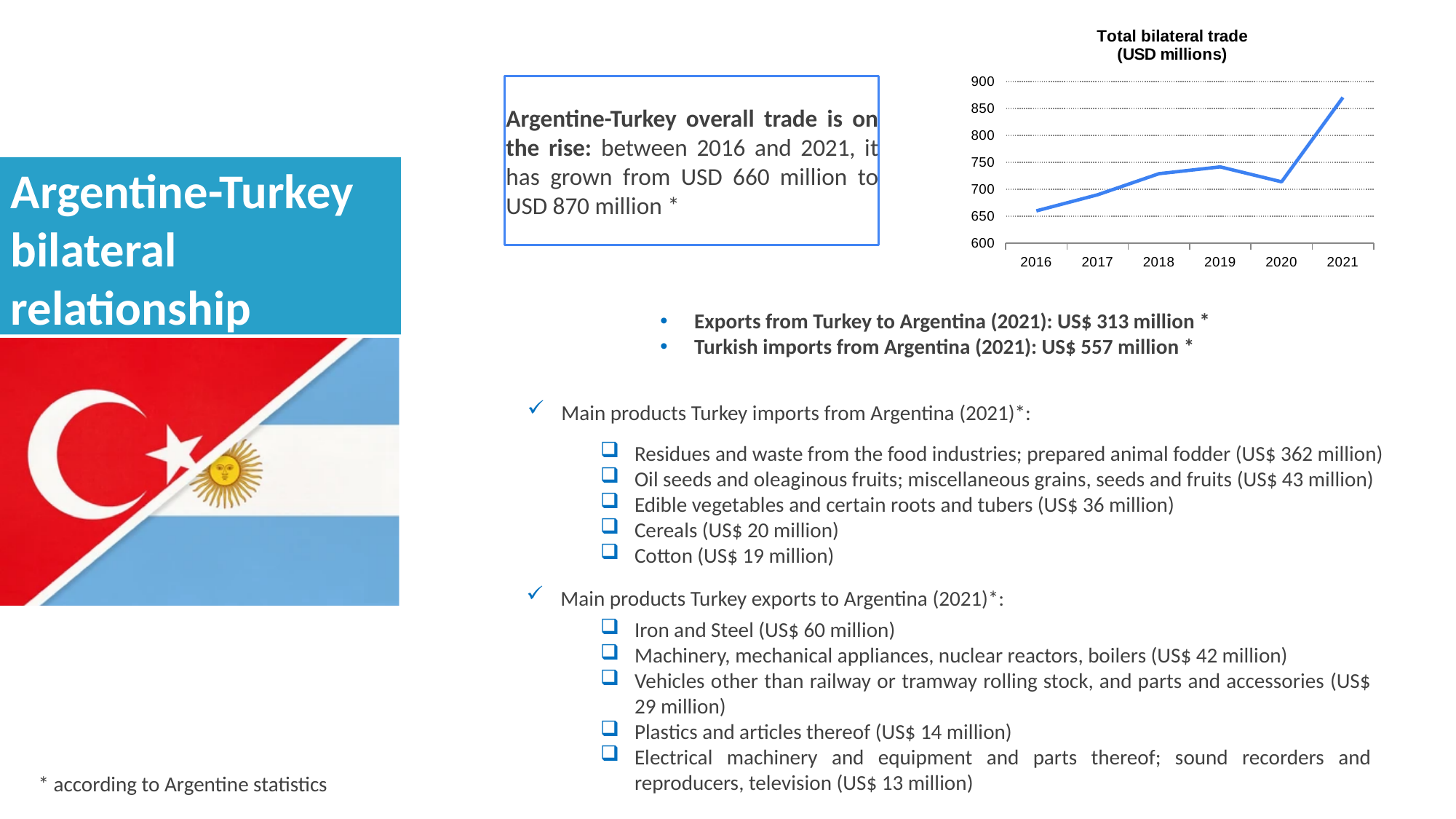
Which year has the lowest total bilateral trade in the chart? 2016 Which year has the highest total bilateral trade in the chart? 2021 Is the value for 2020 greater or less than 700? greater Is the value for 2021 greater or less than 850? greater What kind of chart is shown on the slide? line chart Does the total bilateral trade rise or fall from 2019 to 2020? fall Does the total bilateral trade rise or fall from 2016 to 2019? rise Is the value for 2018 greater or less than 750? less How many years are plotted on the x axis of the chart? 6 What is the title of the chart? Total bilateral trade (USD millions) Which year has a higher value in the chart, 2019 or 2020? 2019